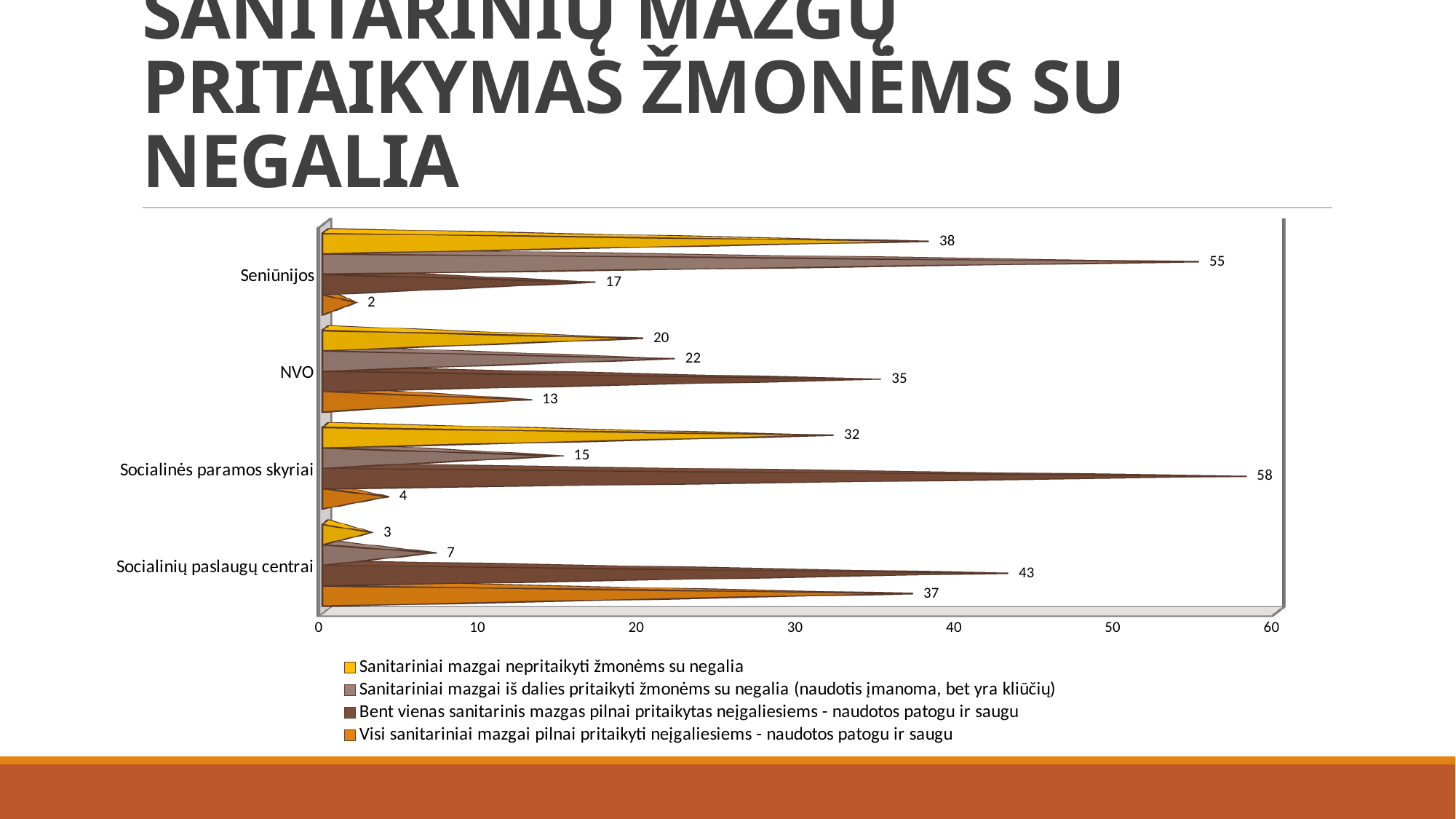
What is the difference between the "Sanitariniai mazgai iš dalies pritaikyti" value for Seniūnijos and for NVO? 33 What is the value for Socialinių paslaugų centrai in the series "Visi sanitariniai mazgai pilnai pritaikyti neįgaliesiems - naudotos patogu ir saugu"? 37 What is the value for Socialinės paramos skyriai in the series "Sanitariniai mazgai nepritaikyti žmonėms su negalia"? 32 How many series does the legend list? 4 Which category has the lowest value in the series "Visi sanitariniai mazgai pilnai pritaikyti neįgaliesiems - naudotos patogu ir saugu"? Seniūnijos What is the maximum value shown on the horizontal axis of the chart? 60 How many categories are shown on the vertical axis of the chart? 4 Which is larger for Socialinių paslaugų centrai: the "Bent vienas sanitarinis mazgas pilnai pritaikytas" value or the "Visi sanitariniai mazgai pilnai pritaikyti" value? Bent vienas sanitarinis mazgas pilnai pritaikytas neįgaliesiems - naudotos patogu ir saugu What is the value for NVO in the series "Bent vienas sanitarinis mazgas pilnai pritaikytas neįgaliesiems - naudotos patogu ir saugu"? 35 Which category has the highest value in the series "Bent vienas sanitarinis mazgas pilnai pritaikytas neįgaliesiems - naudotos patogu ir saugu"? Socialinės paramos skyriai What kind of chart is shown on the slide? Bar chart What is the value for Seniūnijos in the series "Sanitariniai mazgai iš dalies pritaikyti žmonėms su negalia (naudotis įmanoma, bet yra kliūčių)"? 55